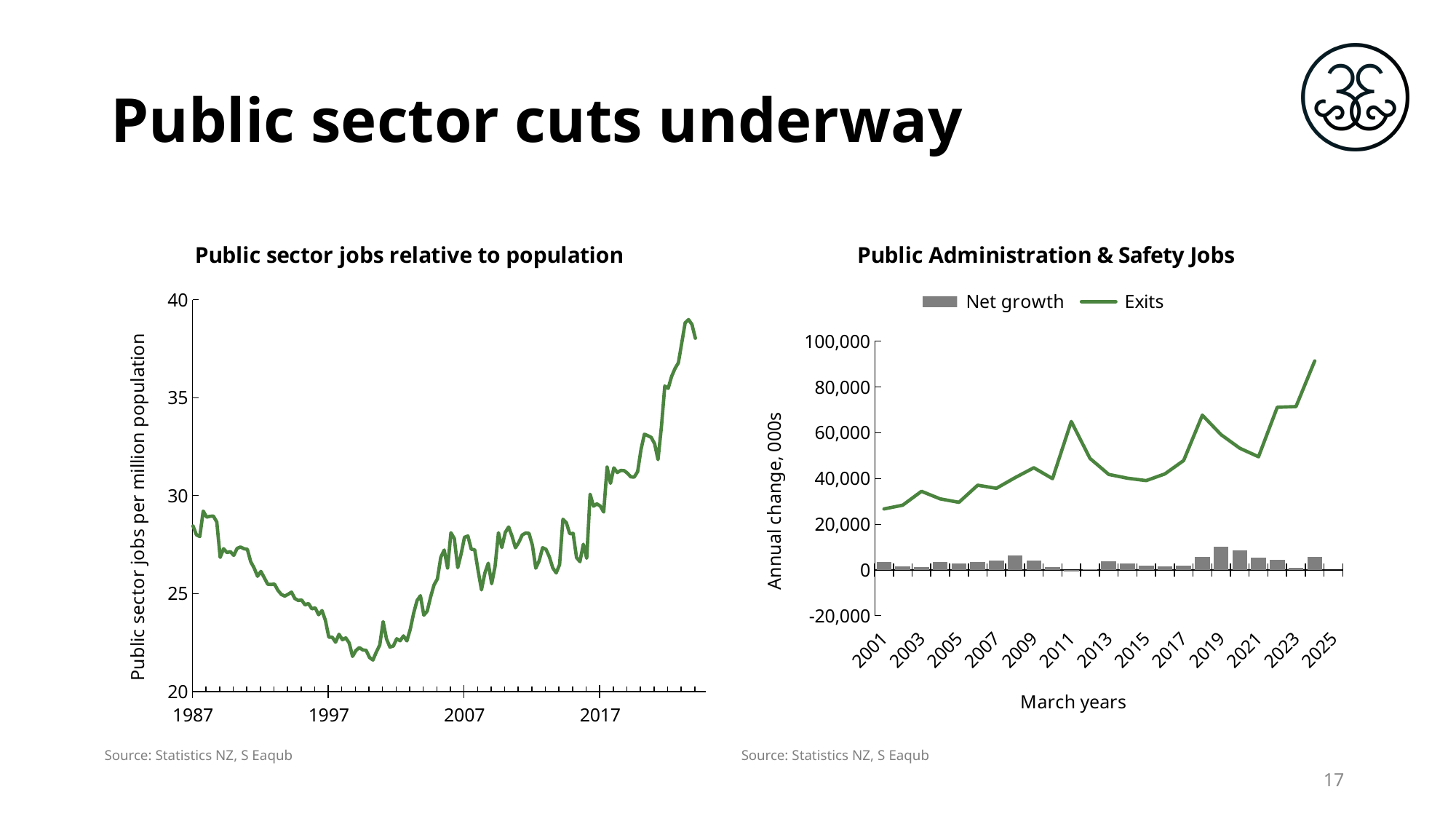
In the 'Public Administration & Safety Jobs' chart, which series is drawn as bars? Net growth In the 'Public Administration & Safety Jobs' chart, is the Exits value for 2011 greater or less than 60,000? greater In the 'Public sector jobs relative to population' chart, do values rise or fall between 1987 and 1997? fall In the 'Public Administration & Safety Jobs' chart, which year has the highest Net growth bar? 2019 In the 'Public sector jobs relative to population' chart, is the value in 1997 greater or less than 25? less What kind of chart is the 'Public sector jobs relative to population' chart? line chart What is the y-axis label of the 'Public Administration & Safety Jobs' chart? Annual change, 000s How many series does the legend of the 'Public Administration & Safety Jobs' chart list? 2 In the 'Public Administration & Safety Jobs' chart, do Exits rise or fall between 2021 and 2025? rise In the 'Public Administration & Safety Jobs' chart, which year has the highest Exits value? 2024 In the 'Public sector jobs relative to population' chart, is the value in 1987 greater or less than 25? greater